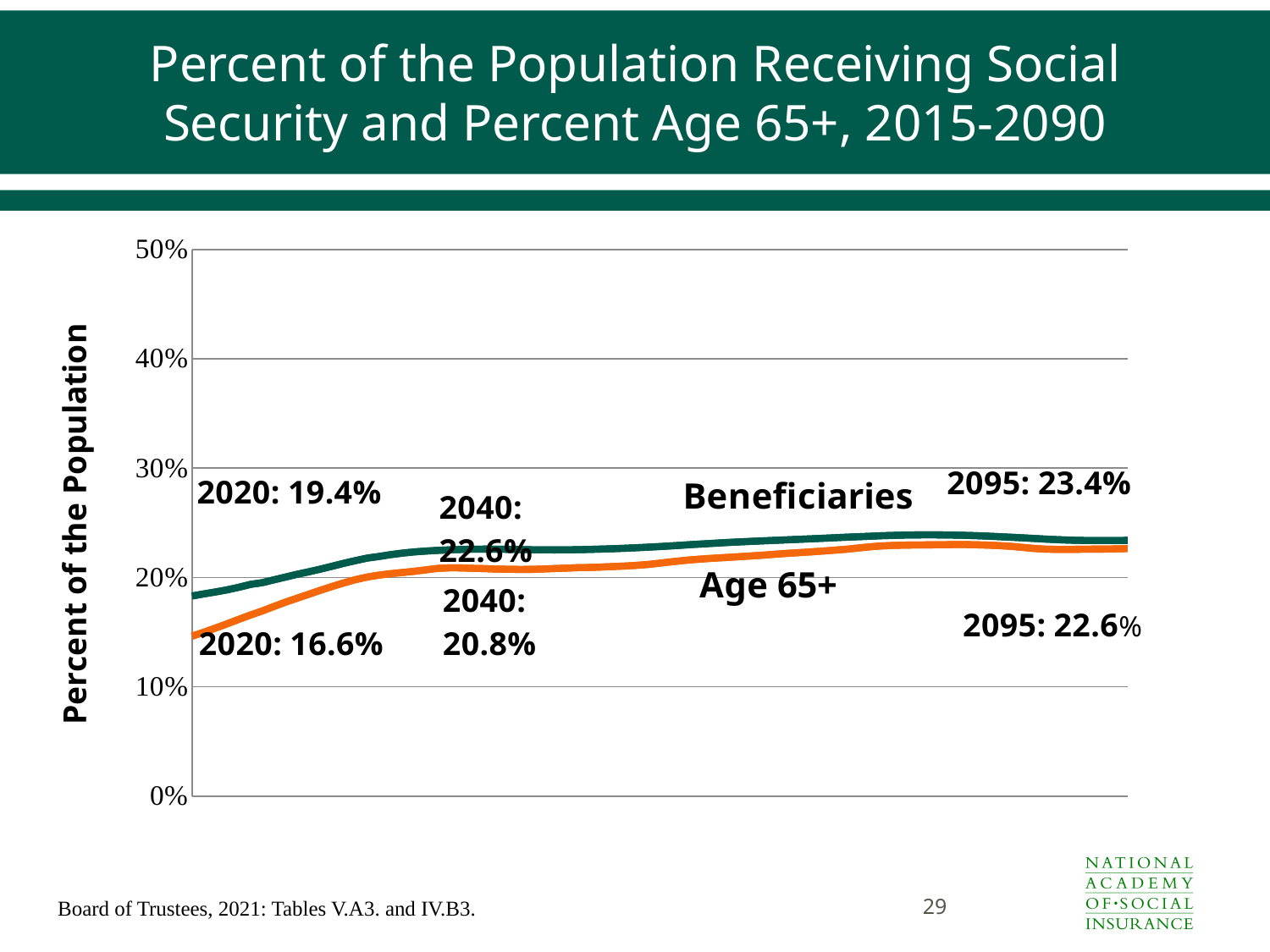
Does the Beneficiaries line generally rise or fall from 2020 to 2095? Rise What percent of the population is projected to be age 65+ in 2095? 22.6% What percent of the population were Social Security beneficiaries in 2020? 19.4% What kind of chart is shown on the slide? Line chart What is the difference between the Beneficiaries and Age 65+ values in 2020? 2.8 percentage points How many series are plotted on the chart? 2 In 2040, which is larger: the Beneficiaries value or the Age 65+ value? Beneficiaries What value is labeled for Age 65+ in 2040? 20.8% What percent of the population is projected to be Social Security beneficiaries in 2095? 23.4% What is the difference between the Beneficiaries and Age 65+ values in 2095? 0.8 percentage points What percent of the population was age 65+ in 2020? 16.6% What value is labeled for Beneficiaries in 2040? 22.6%